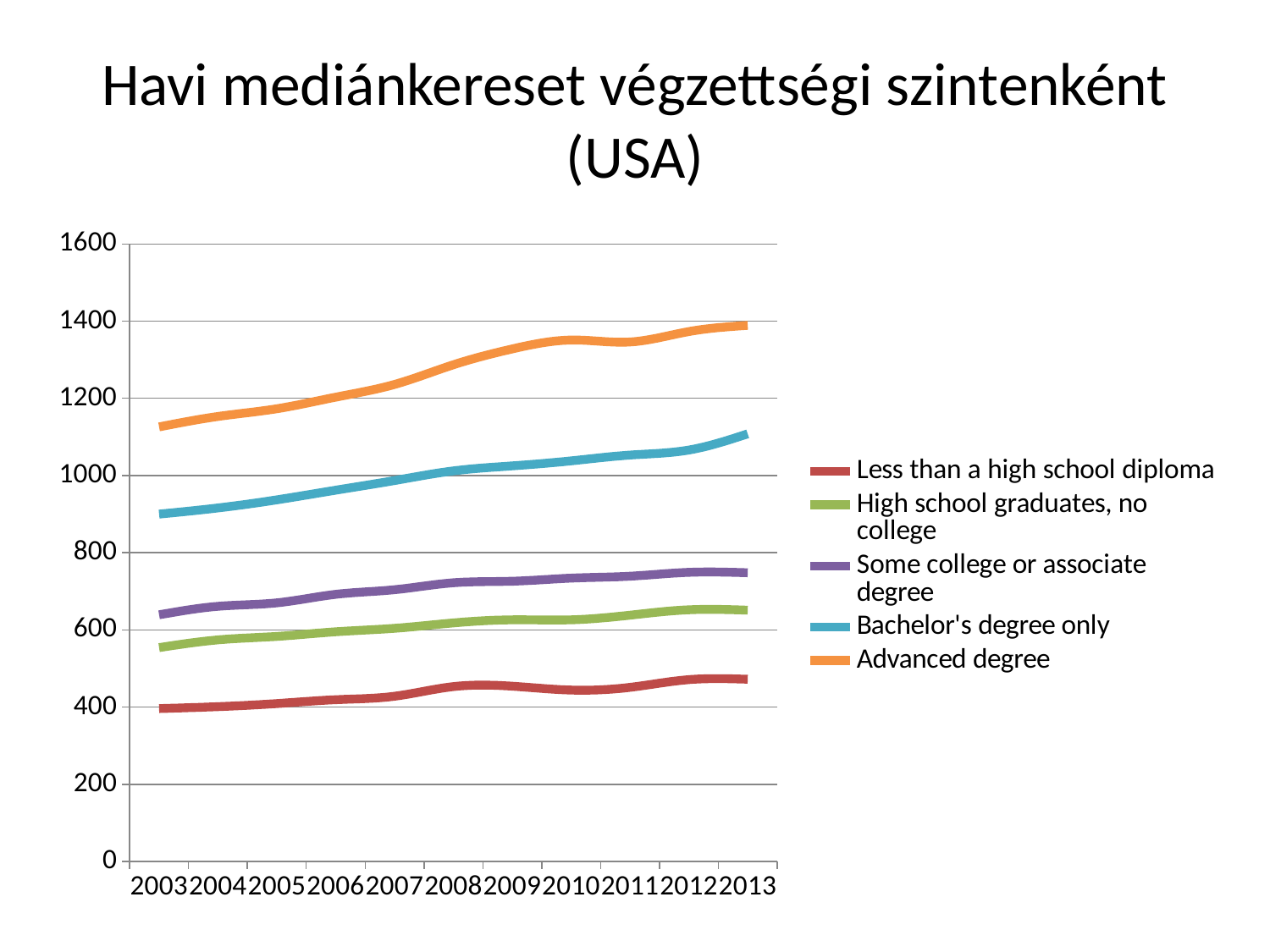
What is the title of the chart on the slide? Havi mediánkereset végzettségi szintenként (USA) Which is larger in 2013: Bachelor's degree only or Some college or associate degree? Bachelor's degree only Is the value for Bachelor's degree only in 2013 greater or less than 1000? greater Is the value for High school graduates, no college in 2003 greater or less than 600? less Which series has the highest values across all years? Advanced degree Is the value for Some college or associate degree in 2013 greater or less than 800? less How many years are shown along the x axis? 11 Does the Advanced degree line generally rise or fall from 2003 to 2013? rise Which series has the lowest values across all years? Less than a high school diploma What kind of chart is shown on the slide? line chart How many series does the legend list? 5